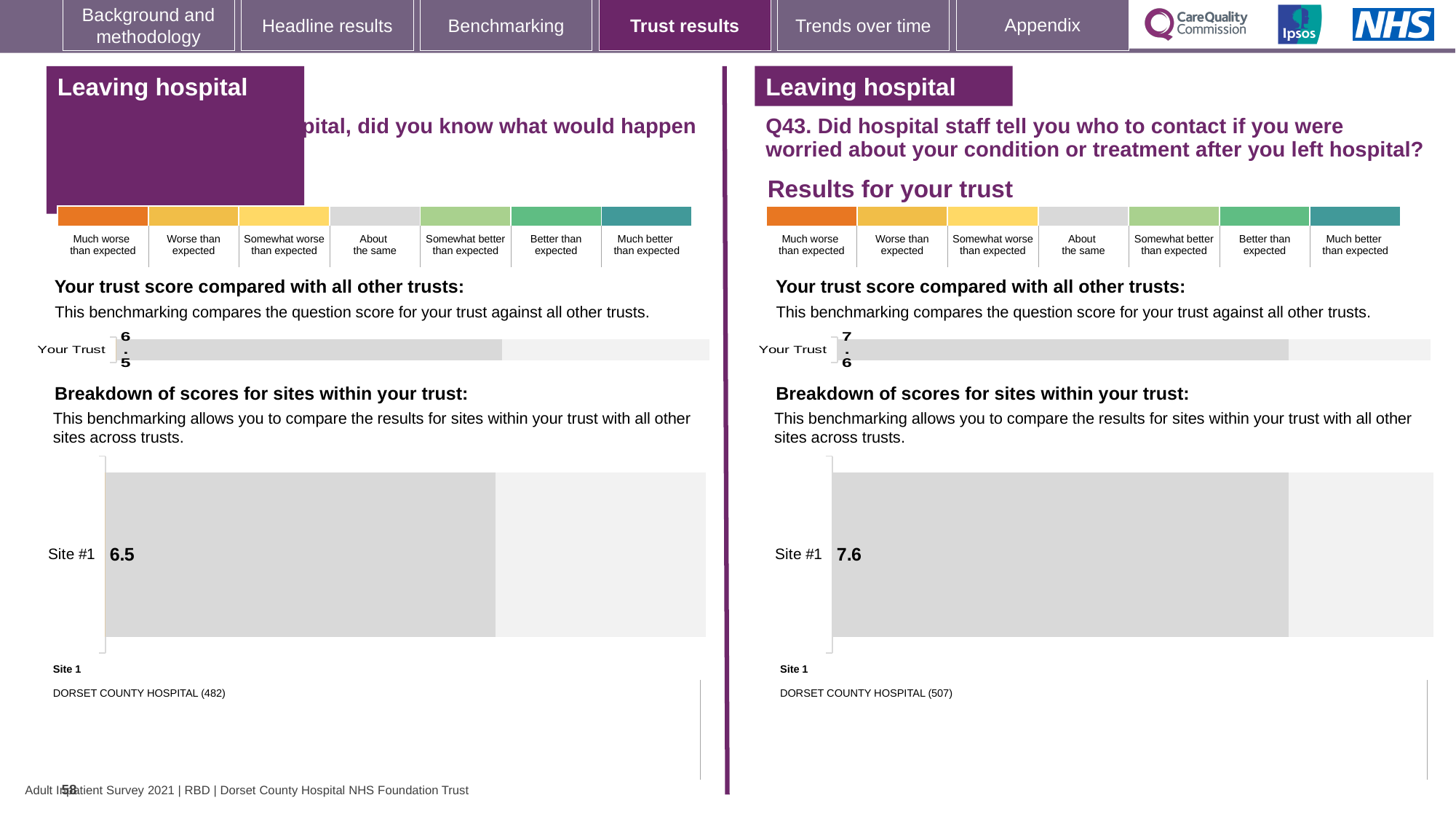
On the left-hand side of the slide, which hospital is listed as Site 1 below the chart? DORSET COUNTY HOSPITAL (482) On the right-hand side of the slide (Q43), what is the 'Your Trust' score in the trust benchmarking chart? 7.6 On the left-hand side of the slide, what is the 'Your Trust' score in the trust benchmarking chart? 6.5 On the right-hand side of the slide (Q43), what is the score shown for Site #1? 7.6 On the left-hand side of the slide, what is the score shown for Site #1? 6.5 How many sites are shown in the 'Breakdown of scores for sites within your trust' chart on the left-hand side of the slide? 1 What is the difference between the Site #1 score on the right-hand side (Q43) and the Site #1 score on the left-hand side of the slide? 1.1 How many sites are shown in the 'Breakdown of scores for sites within your trust' chart on the right-hand side (Q43)? 1 On the right-hand side (Q43), which hospital is listed as Site 1 below the chart? DORSET COUNTY HOSPITAL (507) Which Site #1 score is larger: the one on the left-hand side of the slide or the one on the right-hand side (Q43)? The right-hand side (Q43) What kind of chart is used to show the Site #1 score on each side of the slide? Bar chart